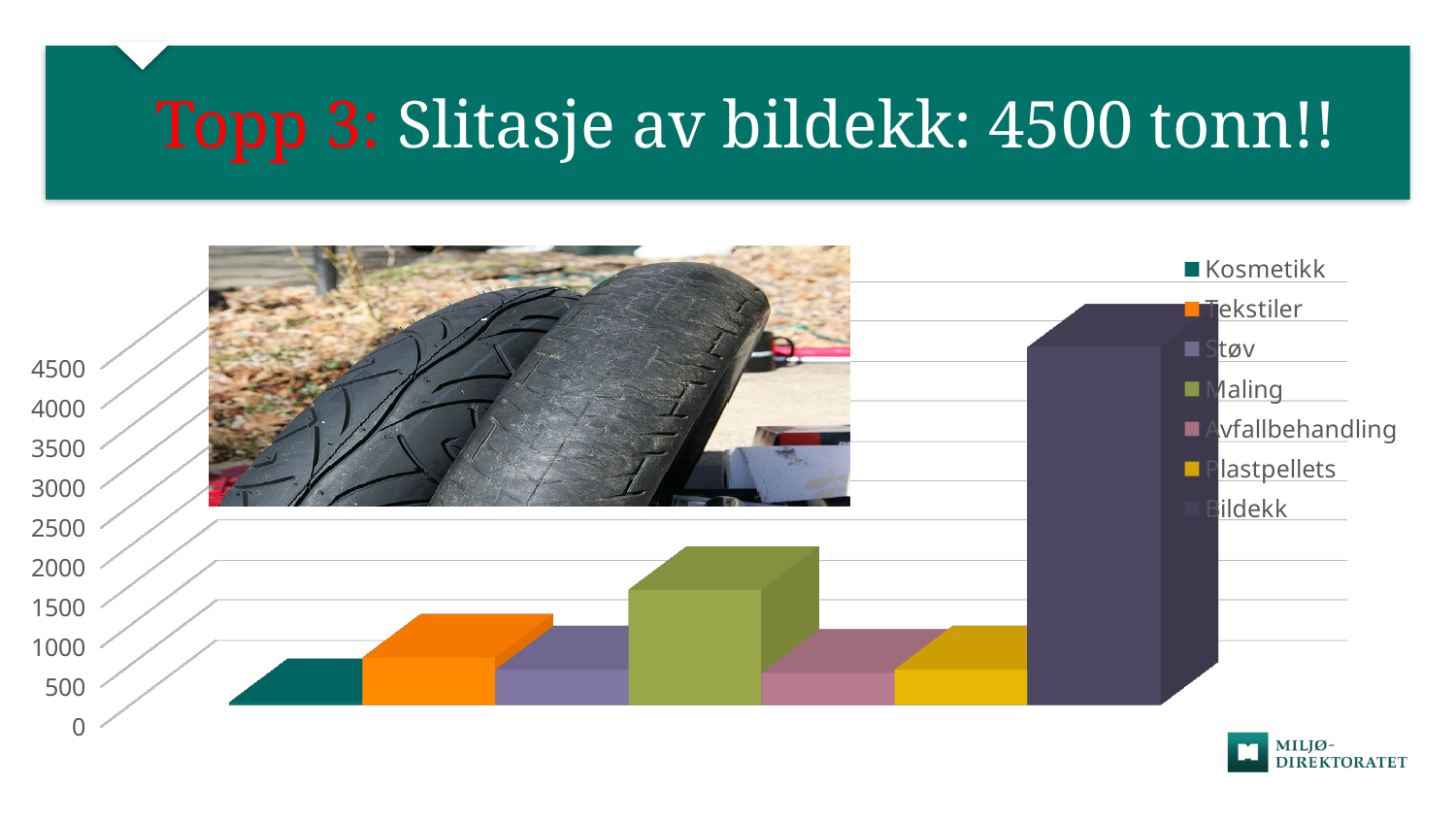
Which series has the highest value in the chart? Bildekk Is the value for Bildekk greater or less than 3000? greater What kind of chart is shown on the slide? bar chart Which is larger, the value for Tekstiler or the value for Kosmetikk? Tekstiler Which series is listed last in the chart legend? Bildekk Which is larger, the value for Bildekk or the value for Maling? Bildekk Is the value for Plastpellets greater or less than 2000? less Is the value for Kosmetikk greater or less than 1000? less How many series does the chart legend list? 7 Which is larger, the value for Maling or the value for Tekstiler? Maling What is the highest value shown on the vertical axis of the chart? 4500